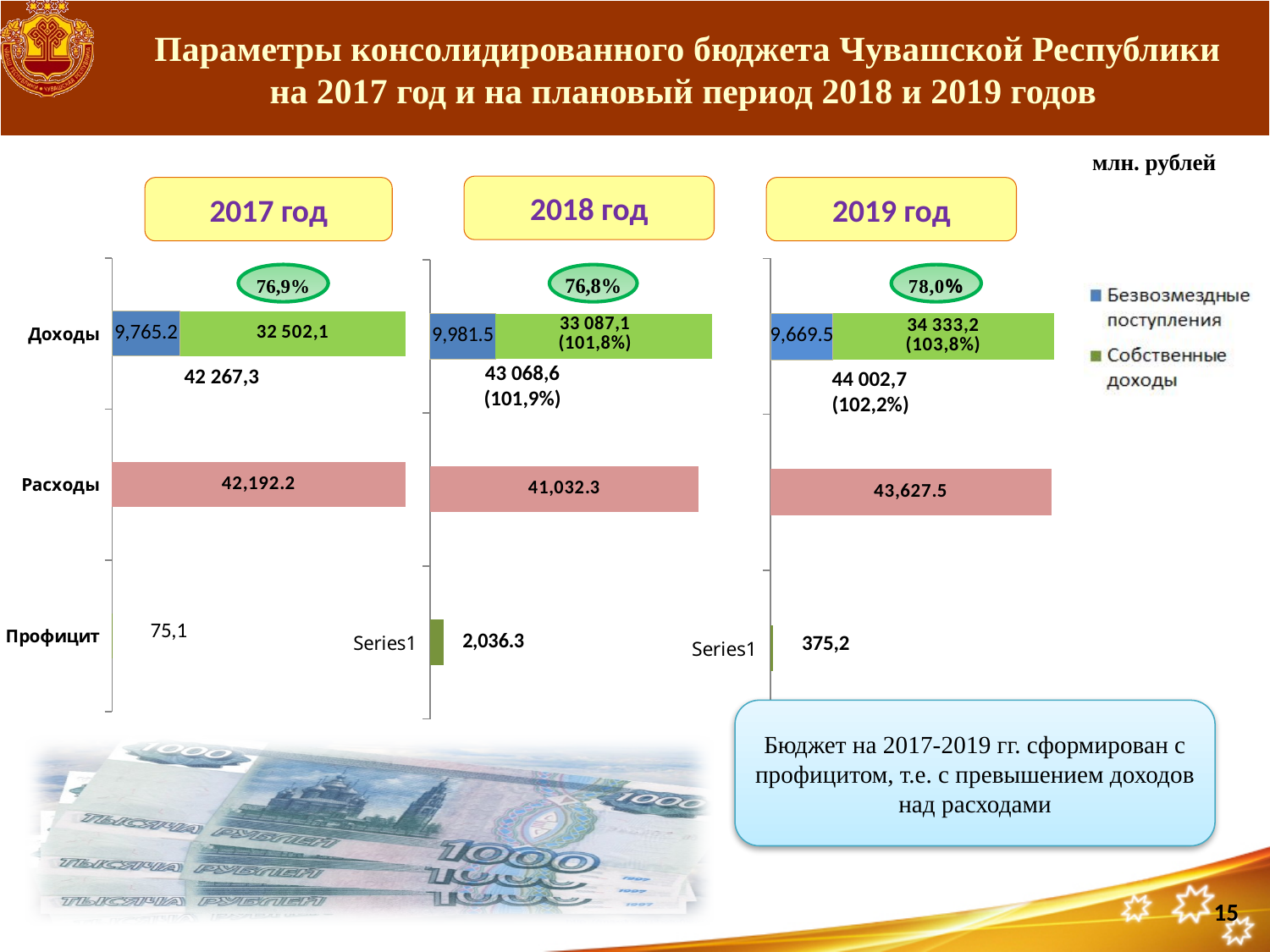
In the 2018 год chart, what is the value shown for Расходы? 41,032.3 In the 2017 год chart, what is the value of Безвозмездные поступления for Доходы? 9,765.2 In the 2017 год chart, which is larger: Доходы or Расходы? Доходы What percentage is shown in the oval above the Доходы bar in the 2019 год chart? 78,0% Which of the three charts shows the highest value for Профицит? 2018 год Which of the three charts shows the lowest value for Расходы? 2018 год What kind of chart is used for the 2019 год data? Bar chart In the 2019 год chart, what is the total of the stacked Доходы bar? 44 002,7 In the 2019 год chart, what is the value shown for Профицит? 375,2 In the 2018 год chart, what is the total of the stacked Доходы bar? 43 068,6 How many series does the legend list? 2 In the 2017 год chart, what is the value of Собственные доходы for Доходы? 32 502,1